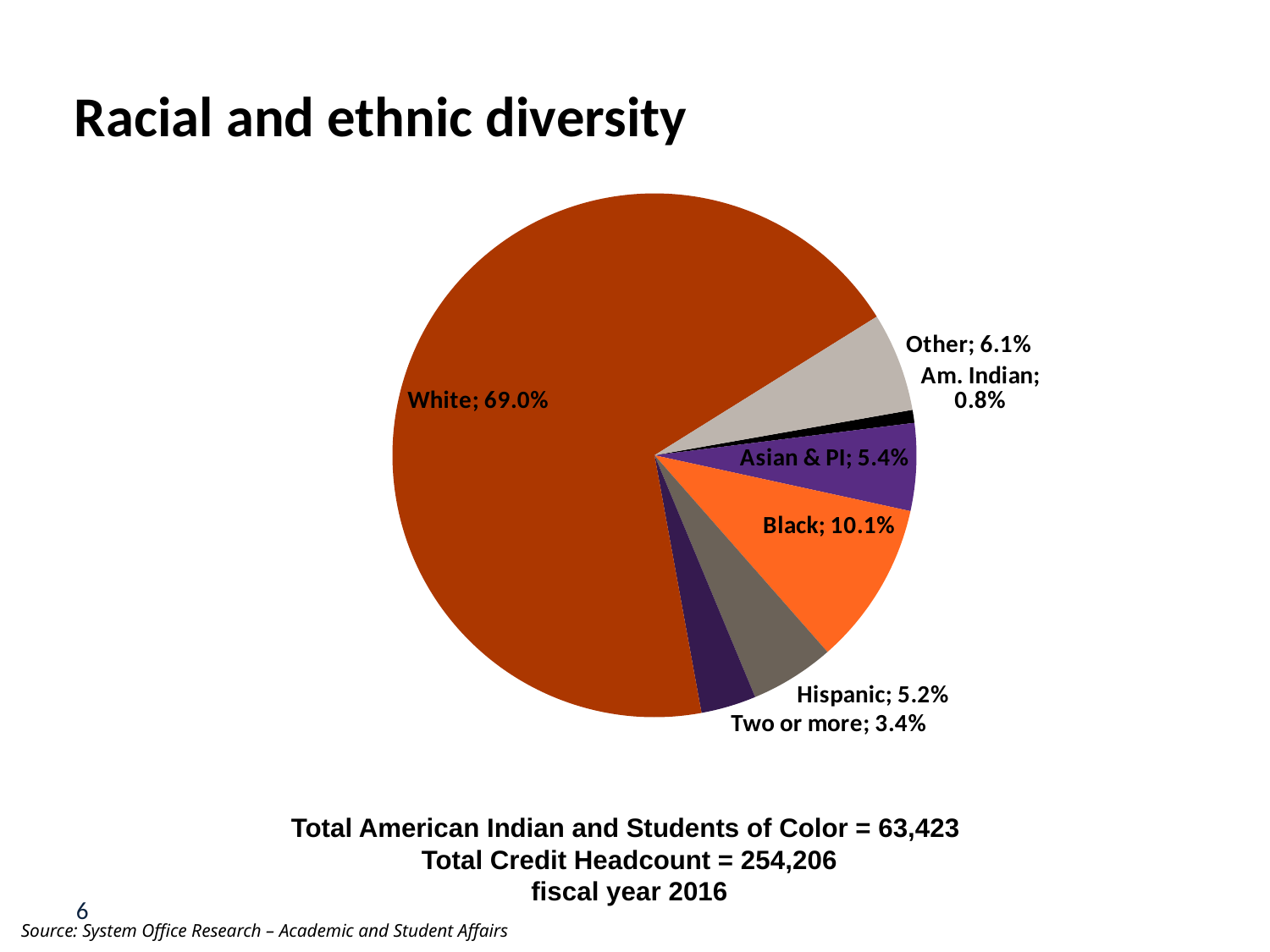
Which category has the largest slice of the pie? White What share of the pie does the White slice represent? 69.0% What is the difference between the Black and Hispanic percentages? 4.9% What kind of chart is shown on the slide? pie chart What is the value shown for Asian & PI? 5.4% Which is larger, the Other slice or the Asian & PI slice? Other What is the value shown for Black? 10.1% What is the title of the slide containing the pie chart? Racial and ethnic diversity What is the value shown for Two or more? 3.4% How many categories are shown in the pie chart? 7 What is the value shown for Am. Indian? 0.8% Which category has the smallest slice of the pie? Am. Indian